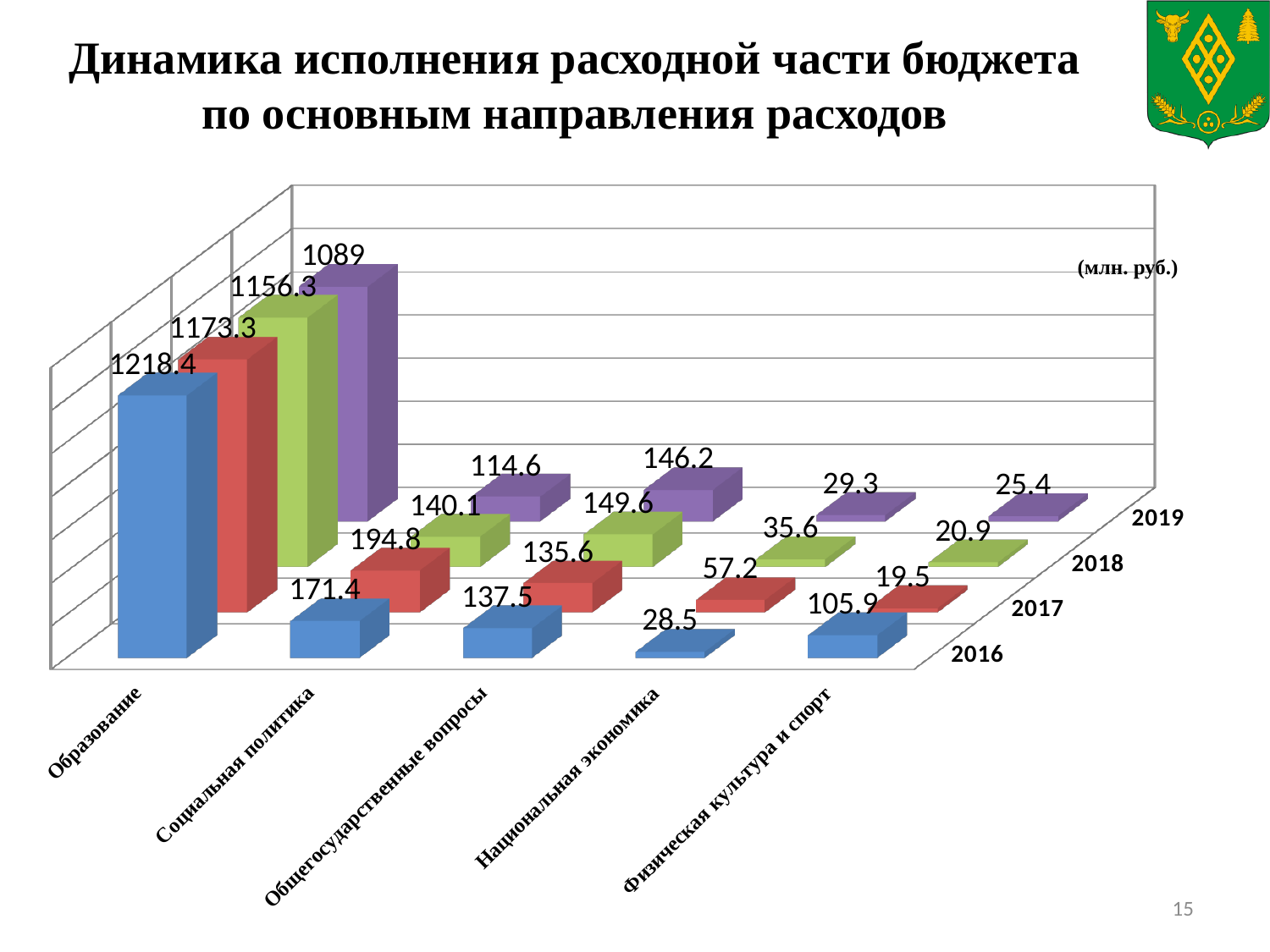
What type of chart is shown on the slide? Bar chart How many spending categories are shown on the x axis? 5 What was the value for Физическая культура и спорт in 2016? 105.9 What was the value for Образование in 2016? 1218.4 What is the difference between the Образование values for 2016 and 2019? 129.4 Did the value for Образование rise or fall from 2016 to 2019? Fall Which is larger: Общегосударственные вопросы in 2018 or Социальная политика in 2018? Общегосударственные вопросы in 2018 Which spending category had the lowest value in 2017? Физическая культура и спорт What was the value for Социальная политика in 2017? 194.8 How many years are plotted in the chart? 4 What was the value for Национальная экономика in 2019? 29.3 Which spending category had the highest value in 2019? Образование